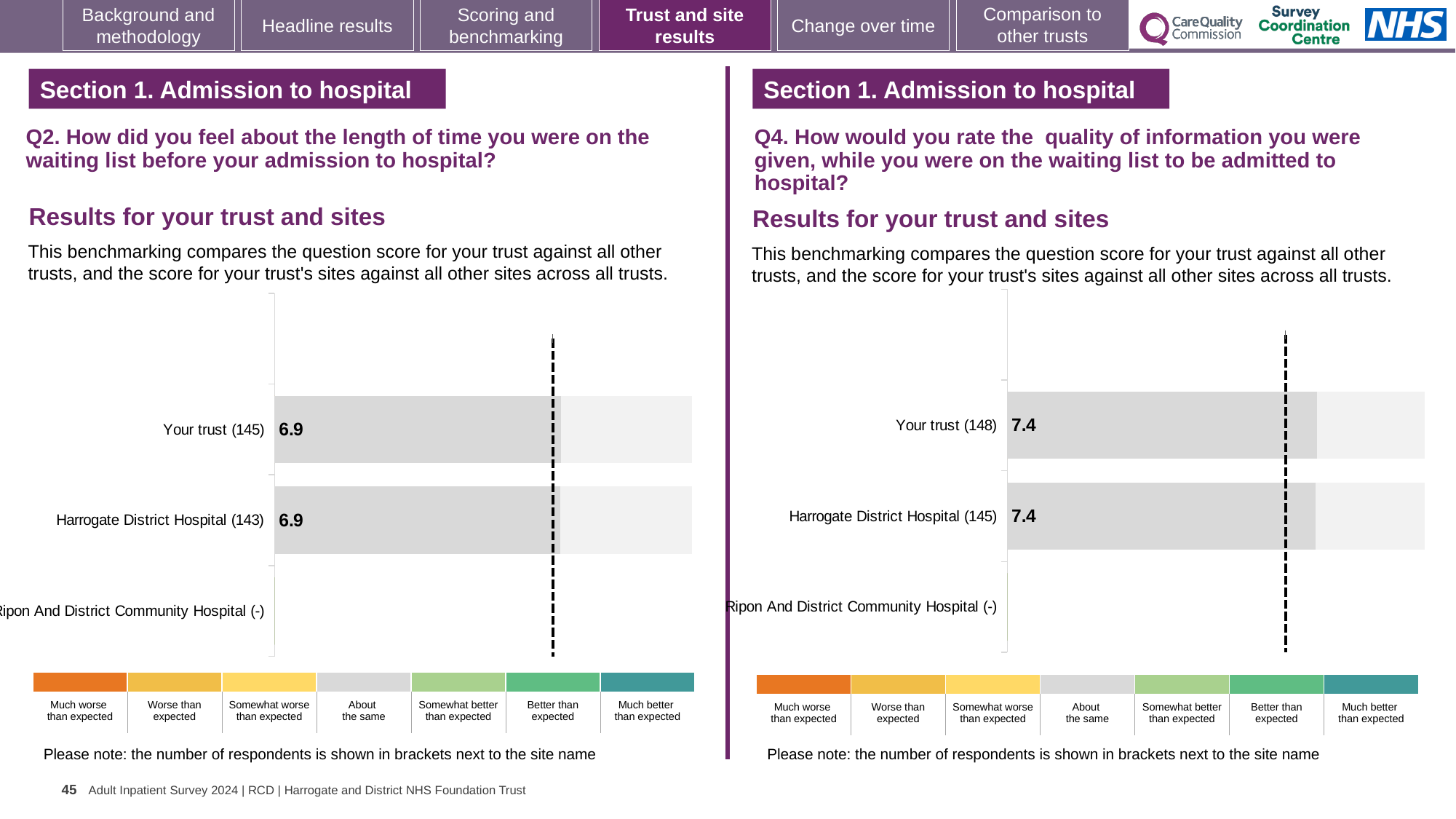
On the Q4 chart (right), what is the difference between the score for Your trust and the score for Harrogate District Hospital? 0.0 On the Q4 chart (right), what is the score for Harrogate District Hospital? 7.4 On the Q4 chart (right), which category has no score shown? Ripon And District Community Hospital On the Q2 chart (left), what is the score for Your trust? 6.9 On the Q4 chart (right), how many respondents are shown in brackets for Your trust? 148 On the Q2 chart (left), what is the difference between the score for Your trust and the score for Harrogate District Hospital? 0.0 What kind of chart is the Q2 chart (left)? Bar chart On the Q2 chart (left), how many respondents are shown in brackets for Harrogate District Hospital? 143 How many categories are listed on the Q2 chart (left)? 3 How many categories are listed on the Q4 chart (right)? 3 On the Q2 chart (left), what is the score for Harrogate District Hospital? 6.9 On the Q4 chart (right), what is the score for Your trust? 7.4